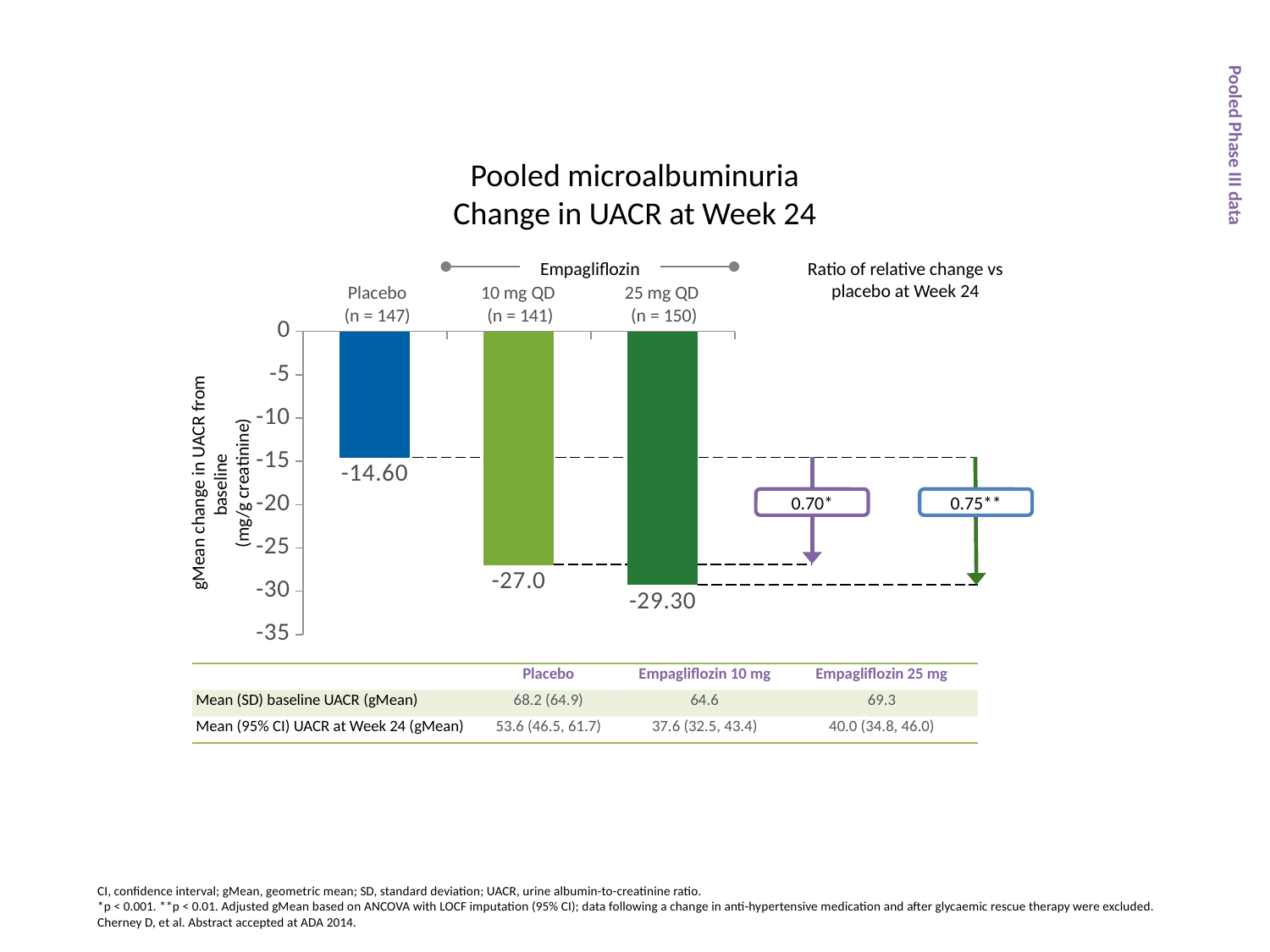
What is the difference between the UACR change for Empagliflozin 25 mg QD and Placebo? 14.70 What is the gMean change in UACR from baseline for Empagliflozin 10 mg QD? -27.0 What is the gMean change in UACR from baseline for Empagliflozin 25 mg QD? -29.30 What is the ratio of relative change vs placebo at Week 24 for Empagliflozin 25 mg QD? 0.75 How many treatment groups are plotted in the chart? 3 Which group shows the largest decrease in UACR from baseline? Empagliflozin 25 mg QD What type of chart is shown on the slide? Bar chart What is the ratio of relative change vs placebo at Week 24 for Empagliflozin 10 mg QD? 0.70 What is the gMean change in UACR from baseline for Placebo? -14.60 Which group shows the smallest decrease in UACR from baseline? Placebo Which group has a larger decrease in UACR: Empagliflozin 10 mg QD or Placebo? Empagliflozin 10 mg QD What is the number of patients (n) in the Empagliflozin 25 mg QD group? 150